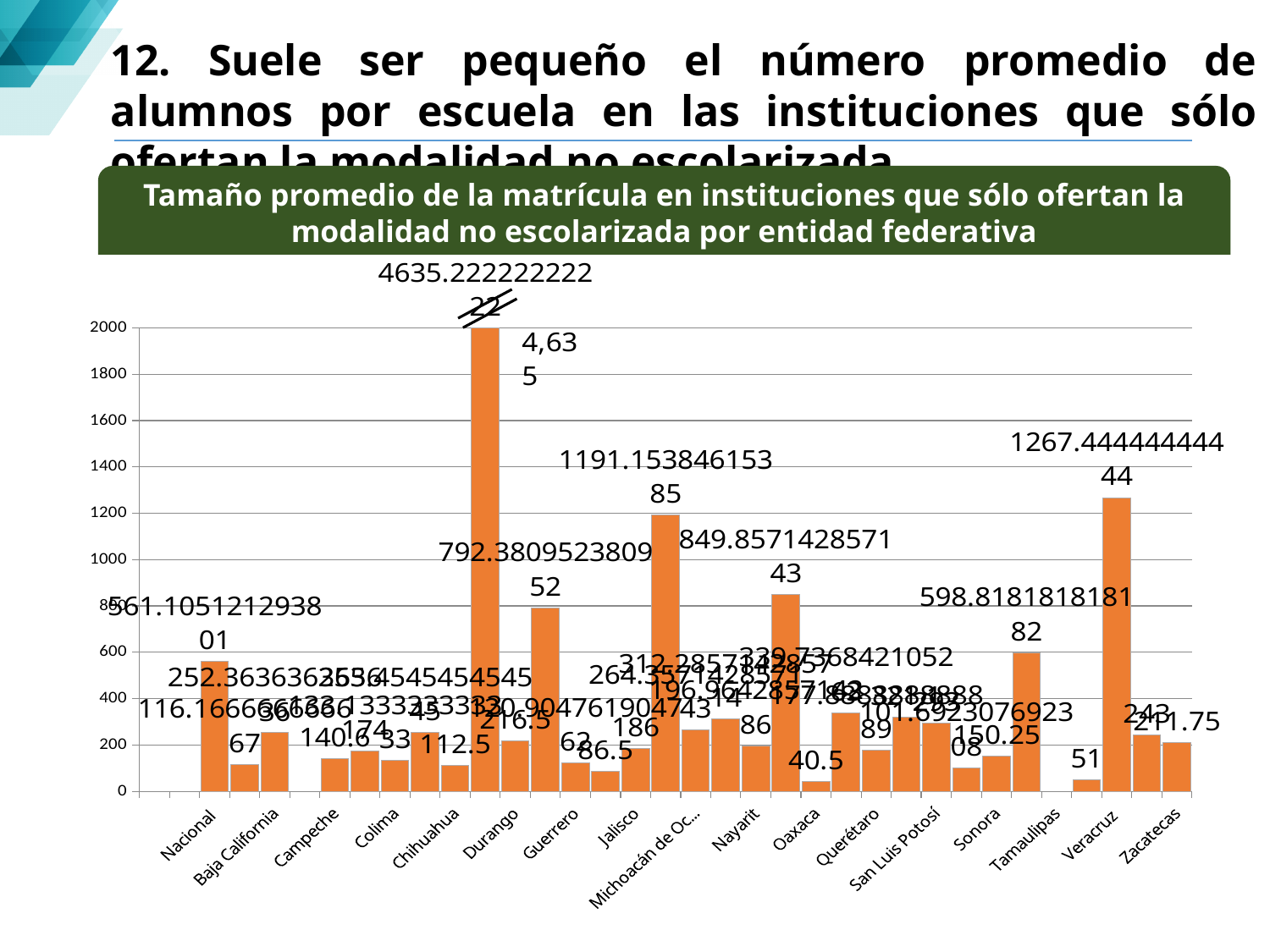
Is the value for Nacional greater or less than 400? greater How many category labels are printed along the x axis of the chart? 17 What kind of chart is shown on the slide? bar chart What colour are the bars in the chart? orange How many data series are plotted in the chart? 1 What is the highest tick value shown on the y axis? 2000 Is the value for Nacional greater or less than 600? less What is the title of the chart? Tamaño promedio de la matrícula en instituciones que sólo ofertan la modalidad no escolarizada por entidad federativa What is the smallest data label value shown in the chart? 40.5 Is the value of the tallest bar greater or less than 2000? greater